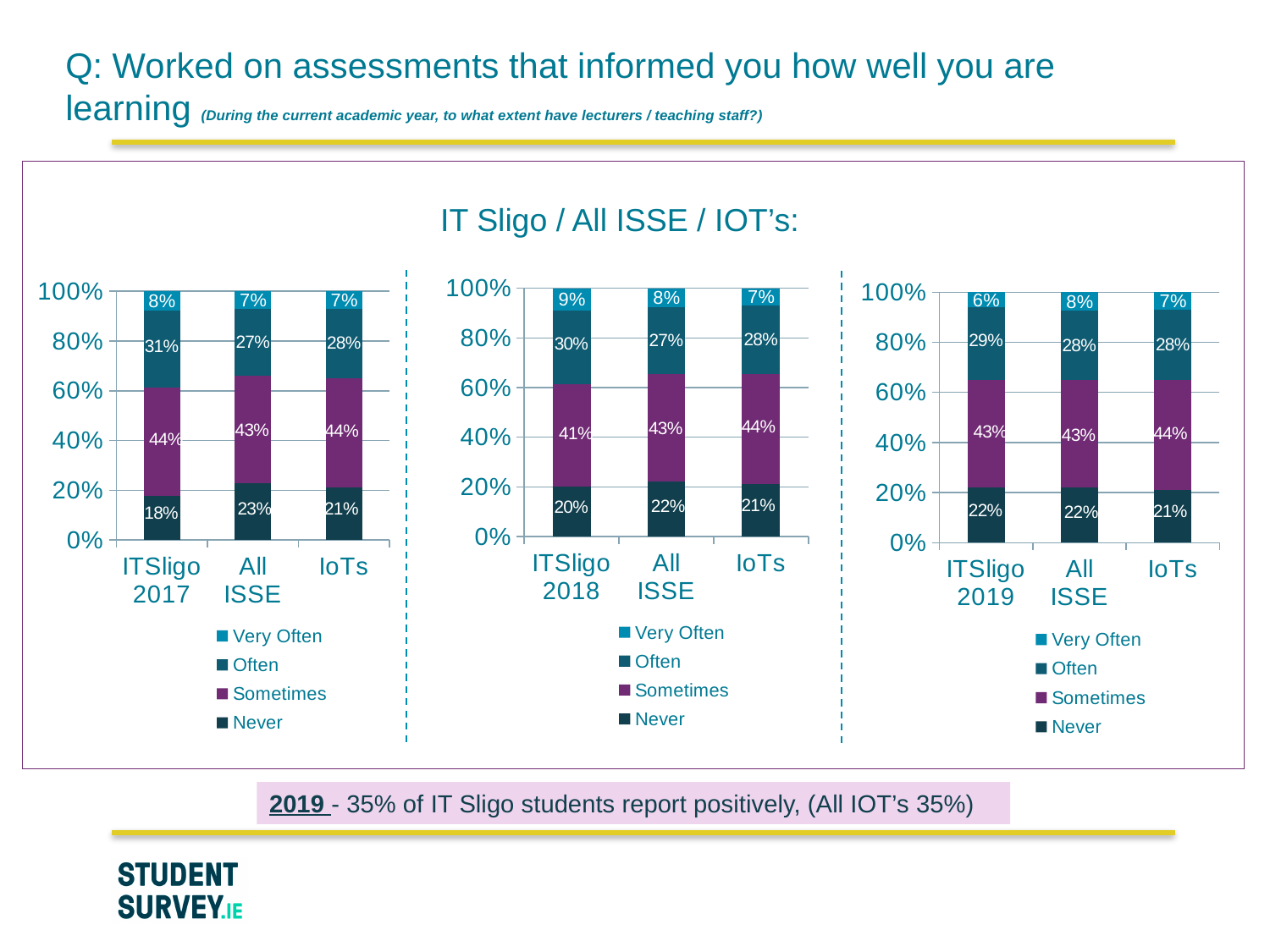
In the middle chart (2018), what is the combined "Often" and "Very Often" share for ITSligo 2018? 39% What type of chart is the left chart (2017)? Stacked bar chart How many categories are shown on the x axis of the right chart (2019)? 3 In the right chart (2019), what is the "Often" value for All ISSE? 28% In the right chart (2019), which category has the lowest "Very Often" value? ITSligo 2019 In the left chart (2017), which category has the highest "Often" value? ITSligo 2017 In the left chart (2017), which is larger: the "Never" value for All ISSE or for ITSligo 2017? All ISSE In the middle chart (2018), what percentage of ITSligo 2018 students answered "Very Often"? 9% In the right chart (2019), what percentage of ITSligo 2019 students answered "Sometimes"? 43% In the left chart (2017), what percentage of ITSligo 2017 students answered "Never"? 18% How many series does the legend of the middle chart (2018) list? 4 In the middle chart (2018), what is the difference between the "Sometimes" values for IoTs and ITSligo 2018? 3%